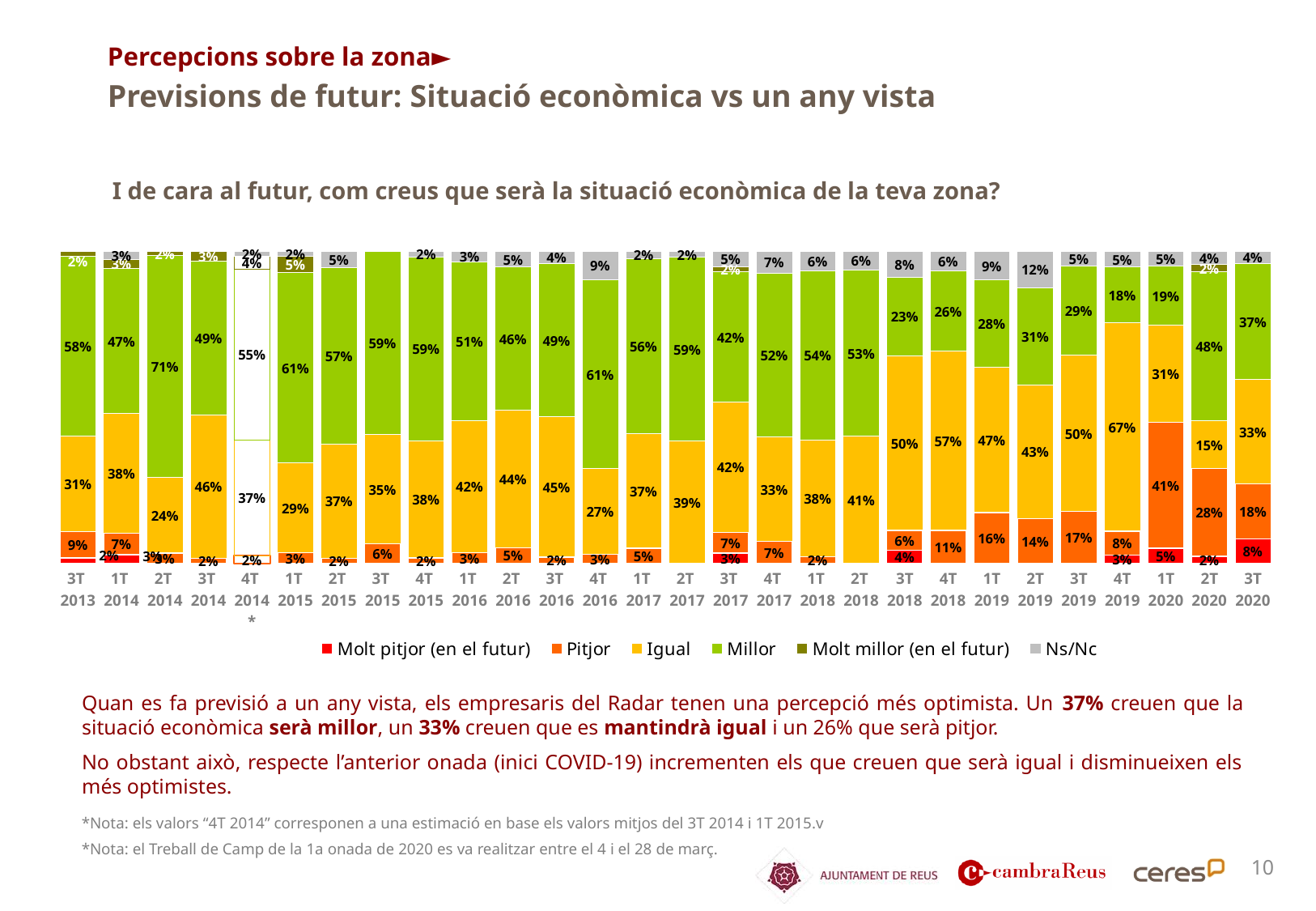
What is the value for 'Millor' in 3T 2020? 37% What is the value for 'Pitjor' in 1T 2020? 41% In which period is the 'Ns/Nc' value highest? 2T 2019 How many periods (bars) are shown on the x axis? 28 What is the value for 'Molt pitjor (en el futur)' in 3T 2020? 8% What type of chart is shown on the slide? stacked bar chart How many series does the legend list? 6 Which colour represents the 'Igual' series in the legend? yellow In which period does 'Millor' reach its highest value? 2T 2014 What is the difference between the 'Pitjor' values in 1T 2020 and 2T 2020? 13% Which is larger, the 'Igual' value in 3T 2020 or the 'Igual' value in 2T 2020? 3T 2020 What is the value for 'Igual' in 4T 2019? 67%